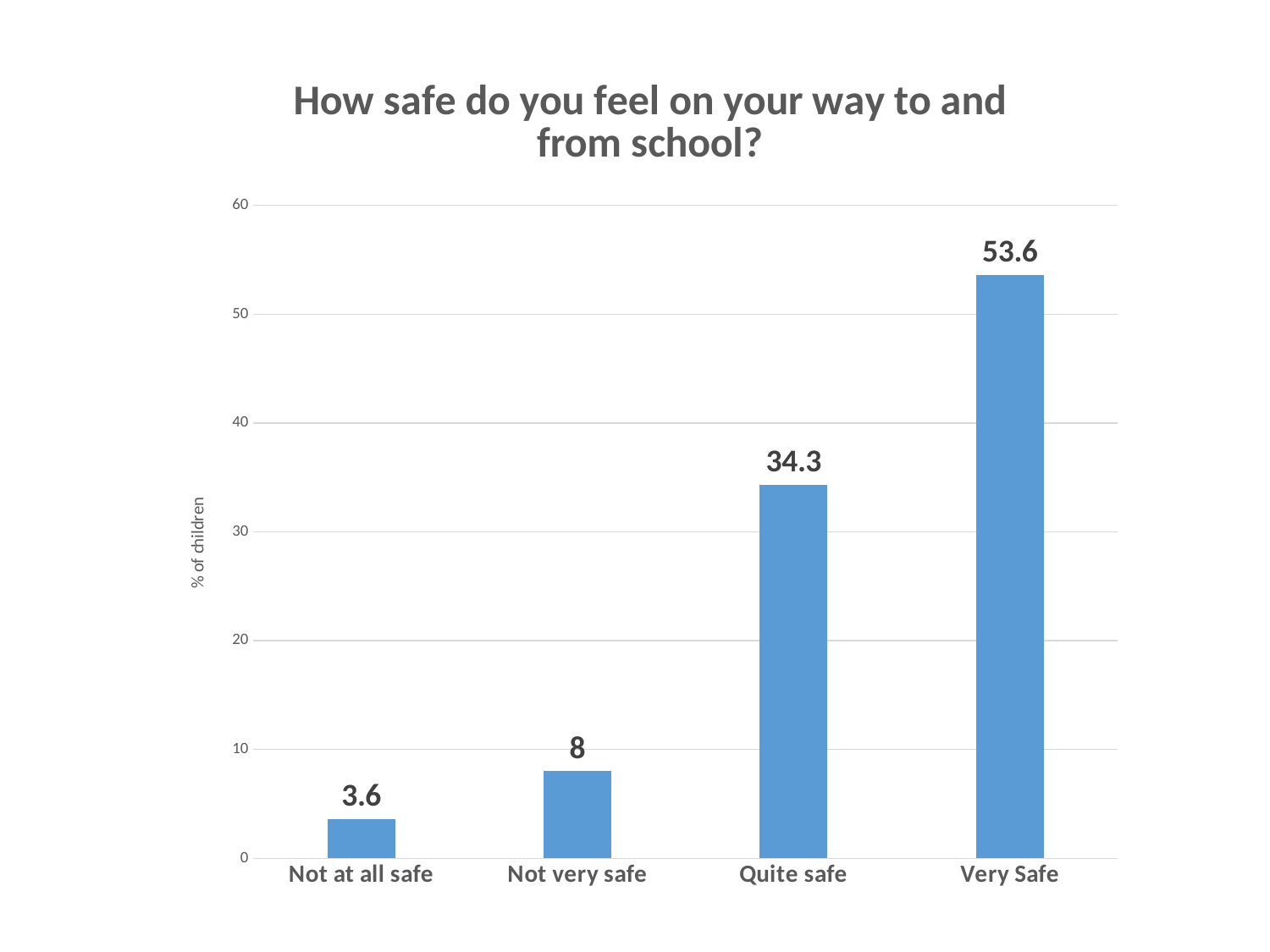
What is the label of the y axis? % of children What is the value for Quite safe? 34.3 What is the difference between the values for Very Safe and Quite safe? 19.3 What is the value for Not very safe? 8 What is the difference between the values for Not very safe and Not at all safe? 4.4 Which category has the highest value? Very Safe What kind of chart is shown on the slide? bar chart How many categories are shown on the x axis? 4 Which is larger, the value for Quite safe or the value for Not very safe? Quite safe Which category has the lowest value? Not at all safe Is the value for Quite safe greater or less than 30? greater What is the value for Very Safe? 53.6